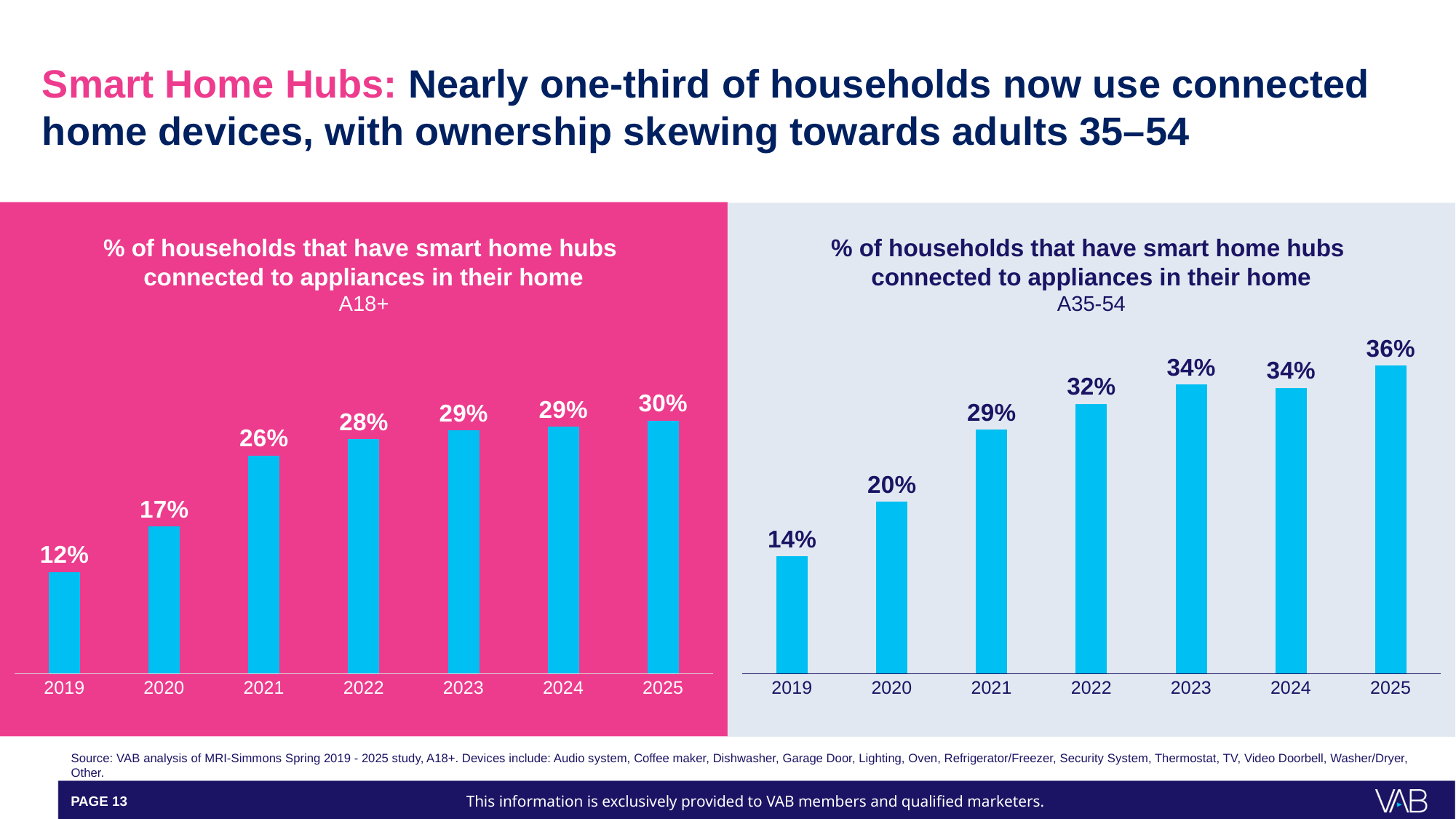
In the left chart (A18+), which year has the highest value? 2025 In the right chart (A35-54), what percentage of households had smart home hubs connected to appliances in 2025? 36% How many years are shown on the x axis of the left chart (A18+)? 7 What type of chart is the right chart (A35-54)? Bar chart In the right chart (A35-54), what is the difference between the 2021 value and the 2020 value? 9 percentage points In the left chart (A18+), do the values generally rise or fall from 2019 to 2025? Rise In the left chart (A18+), what is the difference between the 2025 value and the 2019 value? 18 percentage points What audience group does the left chart cover, as shown in its subtitle? A18+ In the right chart (A35-54), which two years share the same value of 34%? 2023 and 2024 In the right chart (A35-54), which year has the lowest value? 2019 Which is larger: the 2022 value in the left chart (A18+) or the 2022 value in the right chart (A35-54)? The right chart (A35-54), 32% In the left chart (A18+), what percentage of households had smart home hubs connected to appliances in 2019? 12%